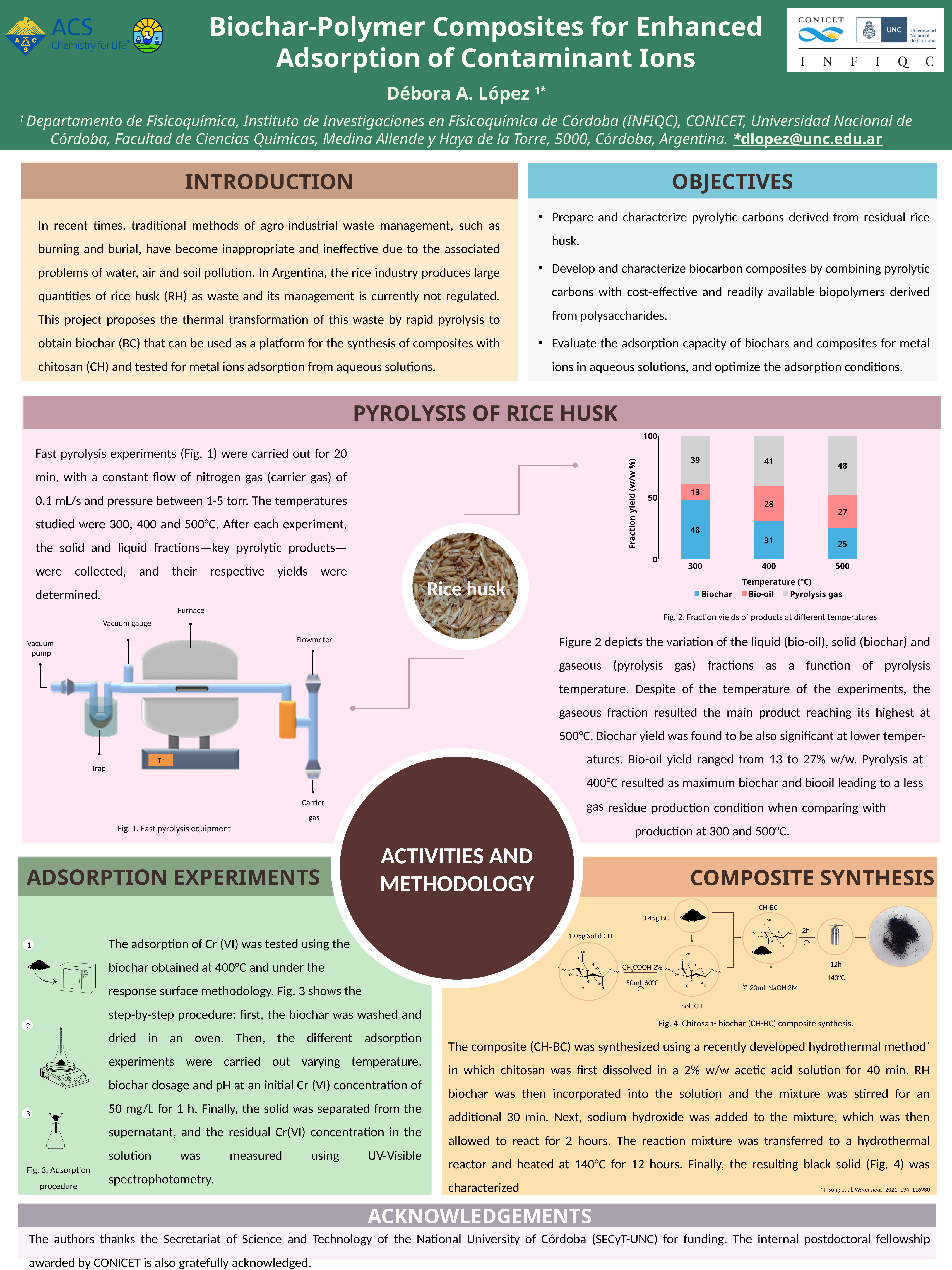
What is the Bio-oil fraction yield at 400 °C? 28 What is the total of the stacked bar at 400 °C? 100 What is the Biochar fraction yield at 300 °C? 48 What kind of chart is Fig. 2? Stacked bar chart How many series does the legend list? 3 What is the Pyrolysis gas fraction yield at 500 °C? 48 Which is larger at 400 °C, the Biochar yield or the Bio-oil yield? Biochar At which temperature is the Biochar fraction yield highest? 300 What is the difference between the Pyrolysis gas yield at 500 °C and at 300 °C? 9 How many temperature categories are shown on the x axis? 3 Does the Biochar fraction yield rise or fall as temperature increases from 300 to 500 °C? Fall At which temperature is the Bio-oil fraction yield lowest? 300